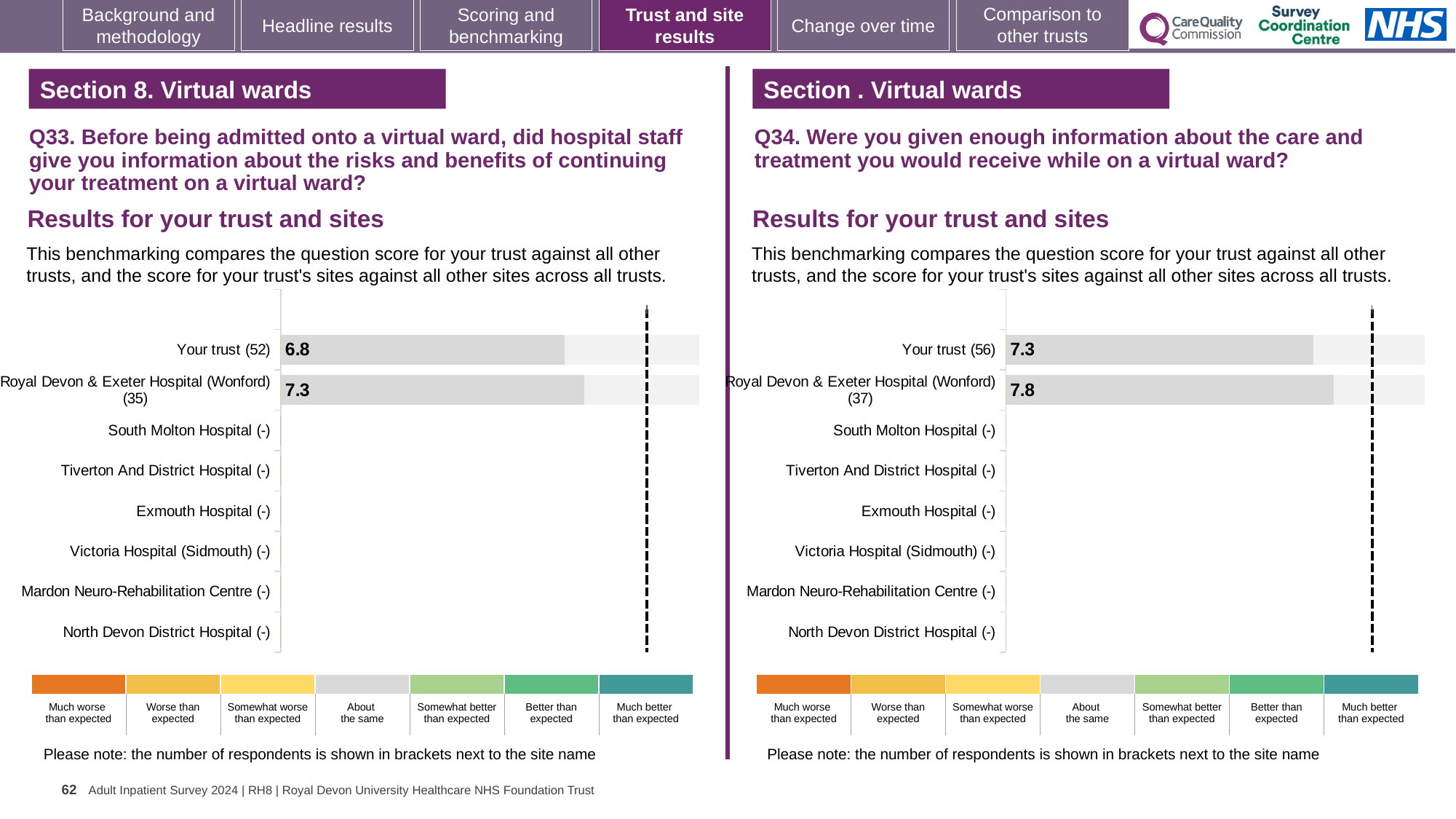
In the Q34 chart on the right, how many respondents are shown in brackets for Royal Devon & Exeter Hospital (Wonford)? 37 In the Q33 chart on the left, which has the higher score: Your trust or Royal Devon & Exeter Hospital (Wonford)? Royal Devon & Exeter Hospital (Wonford) In the Q33 chart on the left, what is the score for Your trust? 6.8 How many site or trust categories are listed on the y axis of the Q33 chart on the left? 8 In the Q34 chart on the right, what is the score for Your trust? 7.3 In the Q33 chart on the left, how many respondents are shown in brackets for Your trust? 52 In the Q34 chart on the right, what is the difference between the Royal Devon & Exeter Hospital (Wonford) score and the Your trust score? 0.5 What type of chart is used for the Q34 results on the right? Bar chart In the Q33 chart on the left, what is the difference between the Royal Devon & Exeter Hospital (Wonford) score and the Your trust score? 0.5 In the Q34 chart on the right, what is the score for Royal Devon & Exeter Hospital (Wonford)? 7.8 In the Q34 chart on the right, which has the higher score: Your trust or Royal Devon & Exeter Hospital (Wonford)? Royal Devon & Exeter Hospital (Wonford) In the Q33 chart on the left, what is the score for Royal Devon & Exeter Hospital (Wonford)? 7.3